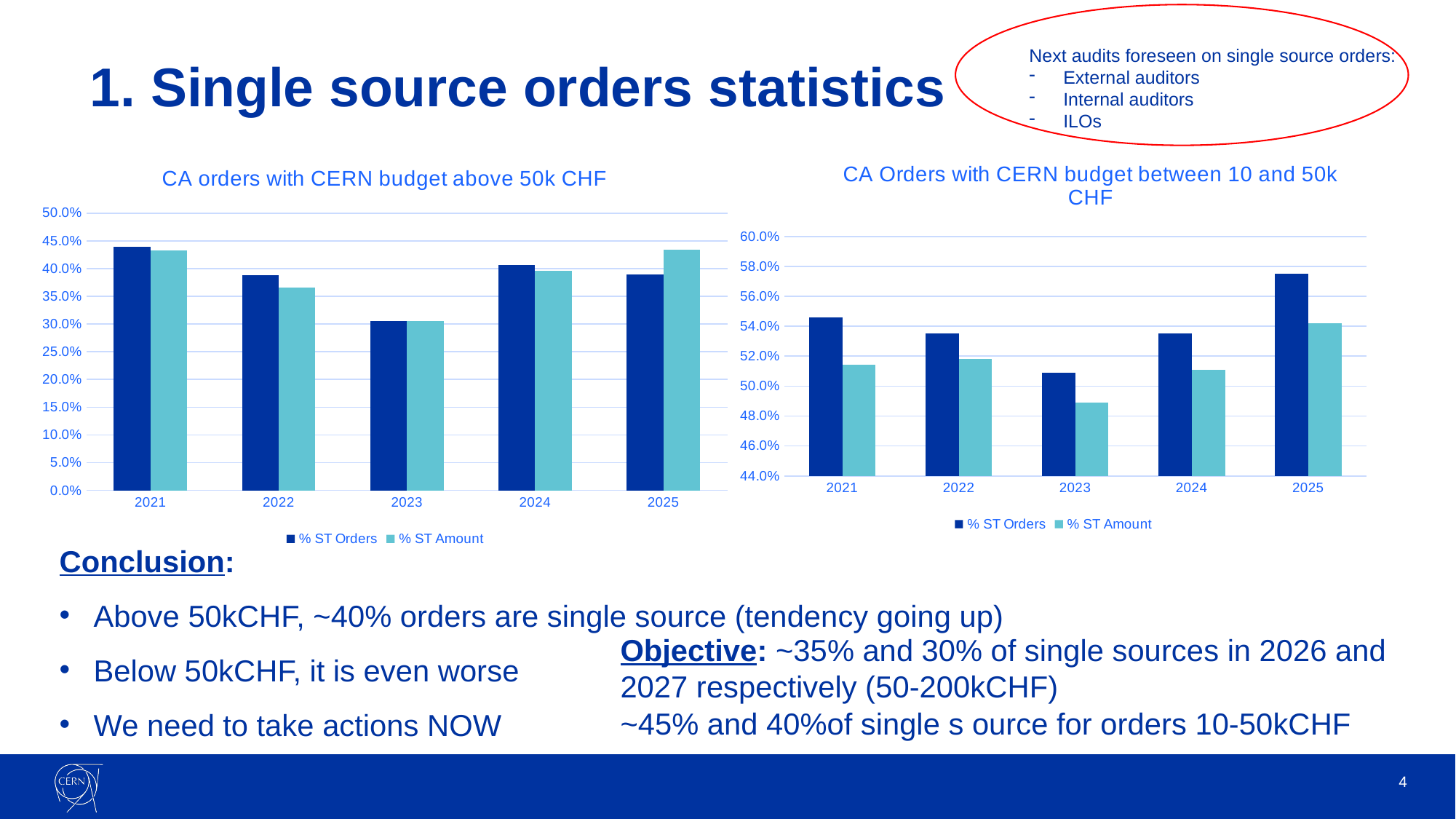
In the chart 'CA orders with CERN budget above 50k CHF', is the value for % ST Orders in 2023 greater or less than 35.0%? less How many series does the legend of the chart 'CA orders with CERN budget above 50k CHF' list? 2 In the chart 'CA orders with CERN budget above 50k CHF', is the value for % ST Orders in 2021 greater or less than 40.0%? greater In the chart 'CA Orders with CERN budget between 10 and 50k CHF', is the value for % ST Amount in 2023 greater or less than 50.0%? less In the chart 'CA orders with CERN budget above 50k CHF', which is larger in 2025, % ST Orders or % ST Amount? % ST Amount In the chart 'CA Orders with CERN budget between 10 and 50k CHF', which is larger in 2021, % ST Orders or % ST Amount? % ST Orders What kind of chart is 'CA Orders with CERN budget between 10 and 50k CHF'? bar chart In the chart 'CA Orders with CERN budget between 10 and 50k CHF', which year has the highest value for % ST Orders? 2025 In the chart 'CA orders with CERN budget above 50k CHF', which year has the lowest value for % ST Orders? 2023 How many years are shown on the x axis of the chart 'CA orders with CERN budget above 50k CHF'? 5 In the chart 'CA Orders with CERN budget between 10 and 50k CHF', which year has the lowest value for % ST Amount? 2023